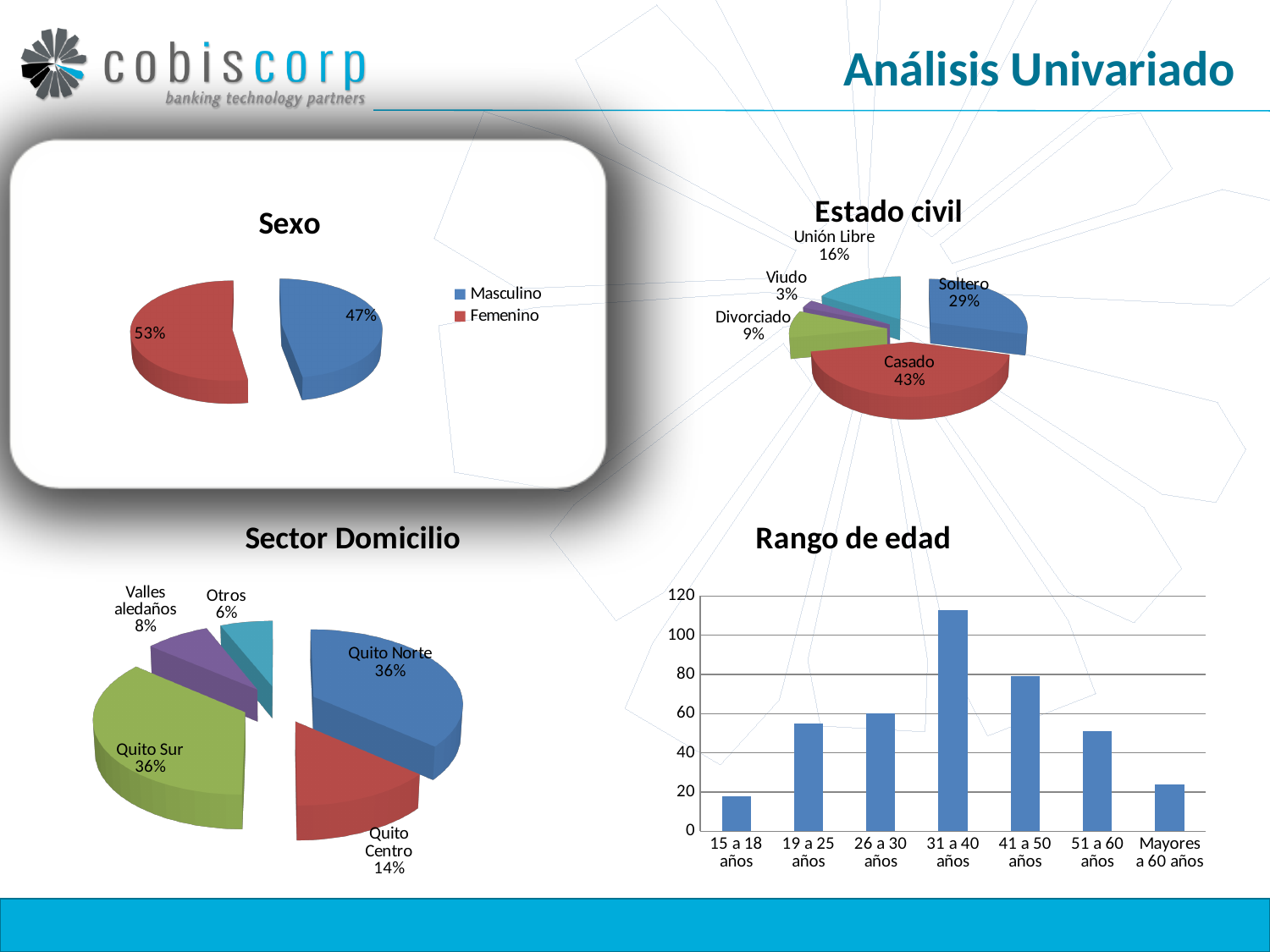
In the Rango de edad chart, which age range has the highest value? 31 a 40 años In the Estado civil chart, what is the difference in percentage points between Soltero and Unión Libre? 13 How many categories does the Estado civil pie chart show? 5 In the Sexo chart, what percentage is Femenino? 53% In the Sexo chart, which category has the larger share, Masculino or Femenino? Femenino In the Sector Domicilio chart, what percentage is Quito Centro? 14% In the Estado civil chart, what percentage is Casado? 43% What type of chart is the Rango de edad chart? bar chart How many age ranges are shown in the Rango de edad chart? 7 In the Rango de edad chart, is the value for 31 a 40 años greater or less than 100? greater In the Estado civil chart, which category has the smallest share? Viudo In the Sector Domicilio chart, what is the combined share of Quito Norte and Quito Sur? 72%